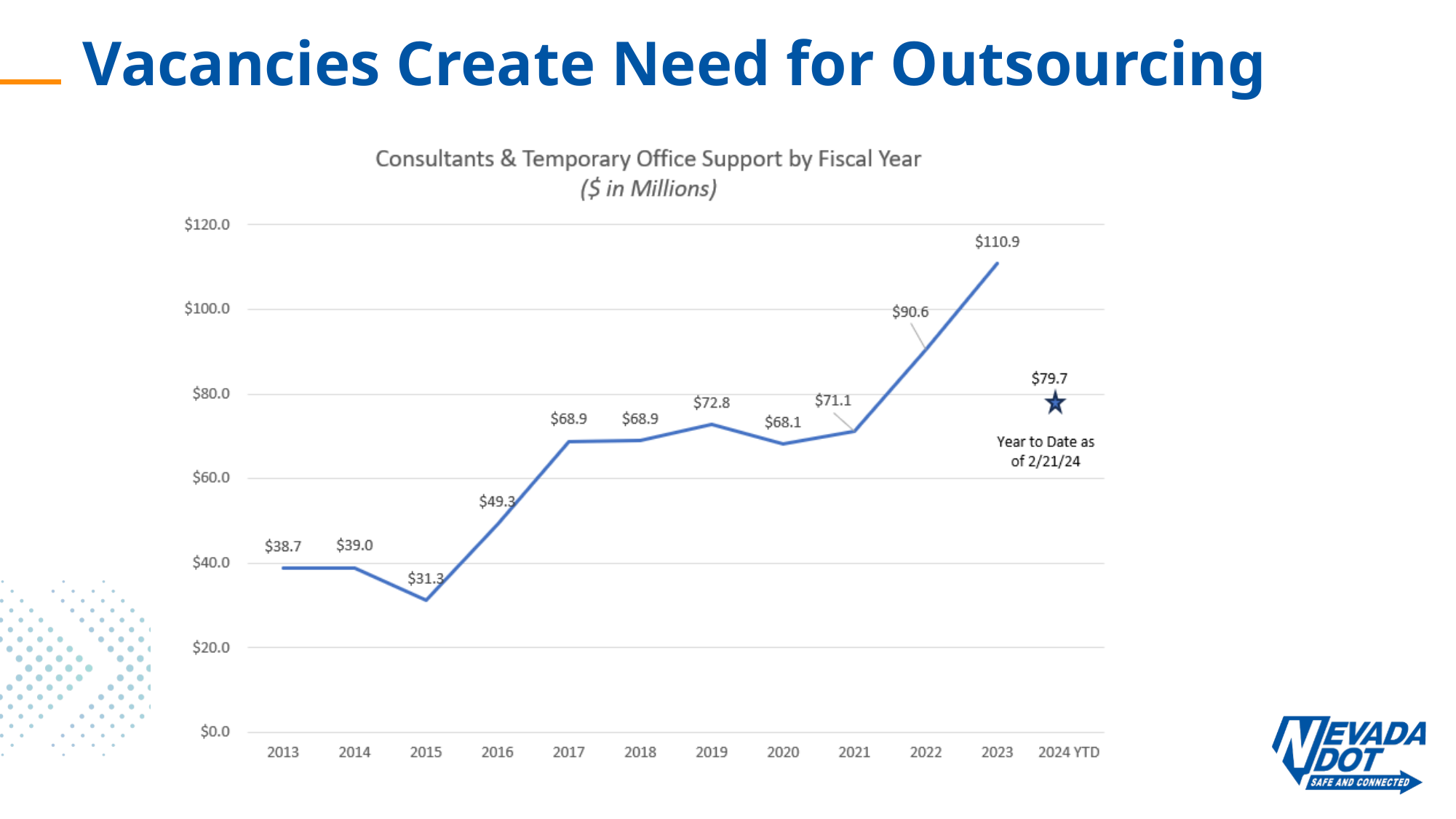
Which is larger, the value for 2019 or the value for 2020? 2019 Is the value for 2022 greater or less than $80.0? greater What is the difference between the values for 2016 and 2015? $18.0 What is the value for 2023? $110.9 What is the value for 2024 YTD? $79.7 How many fiscal year categories are shown on the x axis? 12 Which fiscal year has the lowest value? 2015 Which fiscal year has the highest value? 2023 What type of chart is shown on the slide? Line chart What is the title of the chart? Consultants & Temporary Office Support by Fiscal Year ($ in Millions) What is the value for 2015? $31.3 What is the difference between the values for 2023 and 2022? $20.3